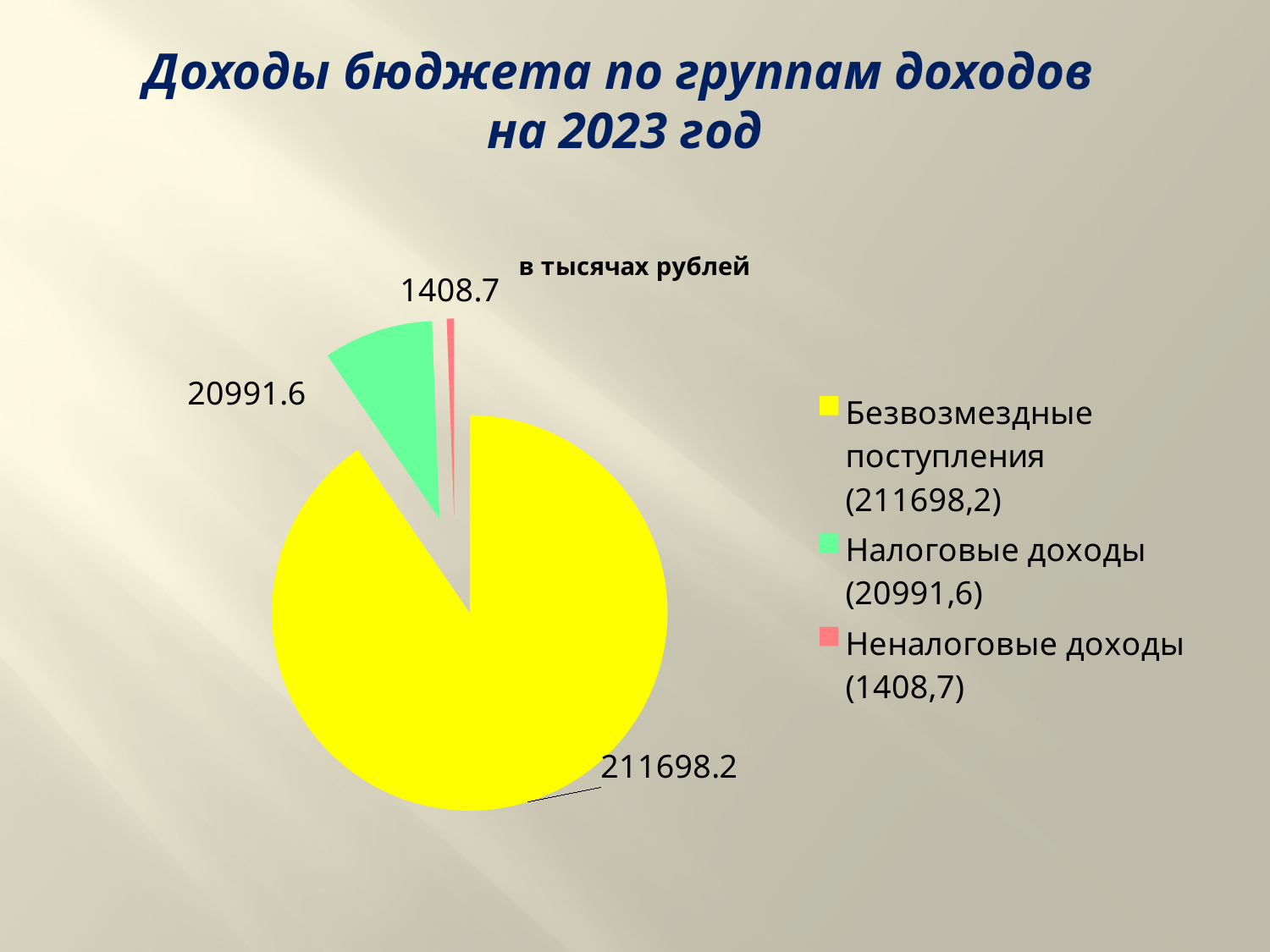
What is the value for Неналоговые доходы? 1408.7 What is the total of all three slices? 234098.5 Which category has the smallest slice of the pie? Неналоговые доходы What is the value for Налоговые доходы? 20991.6 What type of chart is shown on the slide? pie chart How many entries does the legend list? 3 What is the value for Безвозмездные поступления? 211698.2 What is the difference between Налоговые доходы and Неналоговые доходы? 19582.9 Which is larger, Налоговые доходы or Неналоговые доходы? Налоговые доходы How many slices does the pie chart have? 3 What unit is stated above the pie chart? в тысячах рублей Which category has the largest slice of the pie? Безвозмездные поступления